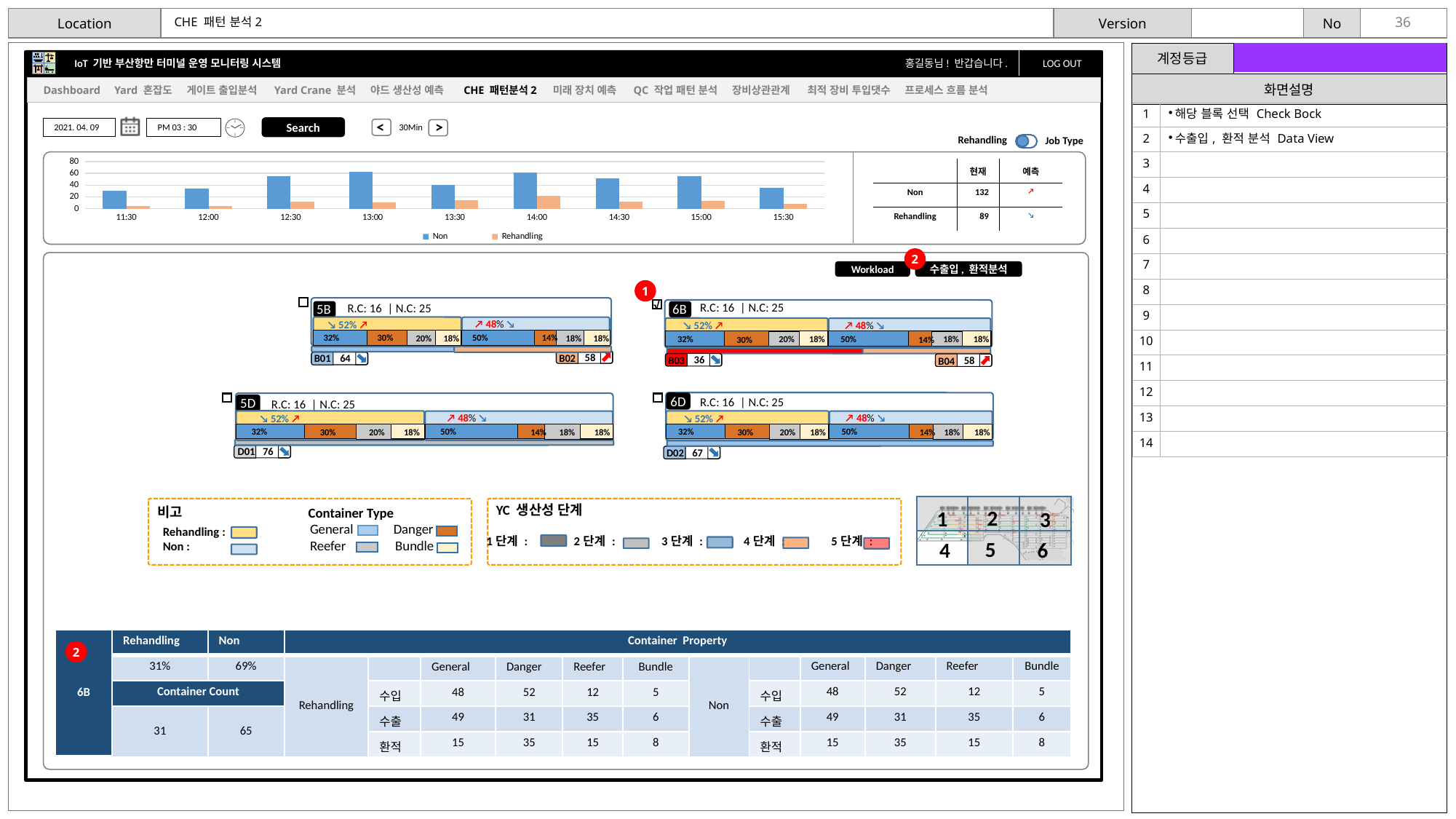
How many time points are shown on the x axis of the top bar chart? 9 In the top bar chart, at 14:00, which series has the larger value, Non or Rehandling? Non In the top bar chart, is the Non value at 13:00 greater or less than 40? greater What kind of chart is shown at the top of the slide, plotting Non and Rehandling over time? bar chart In the top bar chart, which is larger: the Non value at 13:00 or the Non value at 11:30? 13:00 In the top bar chart, is the Rehandling value at 14:00 greater or less than 40? less In the top bar chart, at which time is the Rehandling value highest? 14:00 What are the two series named in the legend of the top bar chart? Non and Rehandling In the top bar chart, is the Non value at 12:30 greater or less than 40? greater What is the highest value shown on the y axis of the top bar chart? 80 How many series does the legend of the top bar chart list? 2